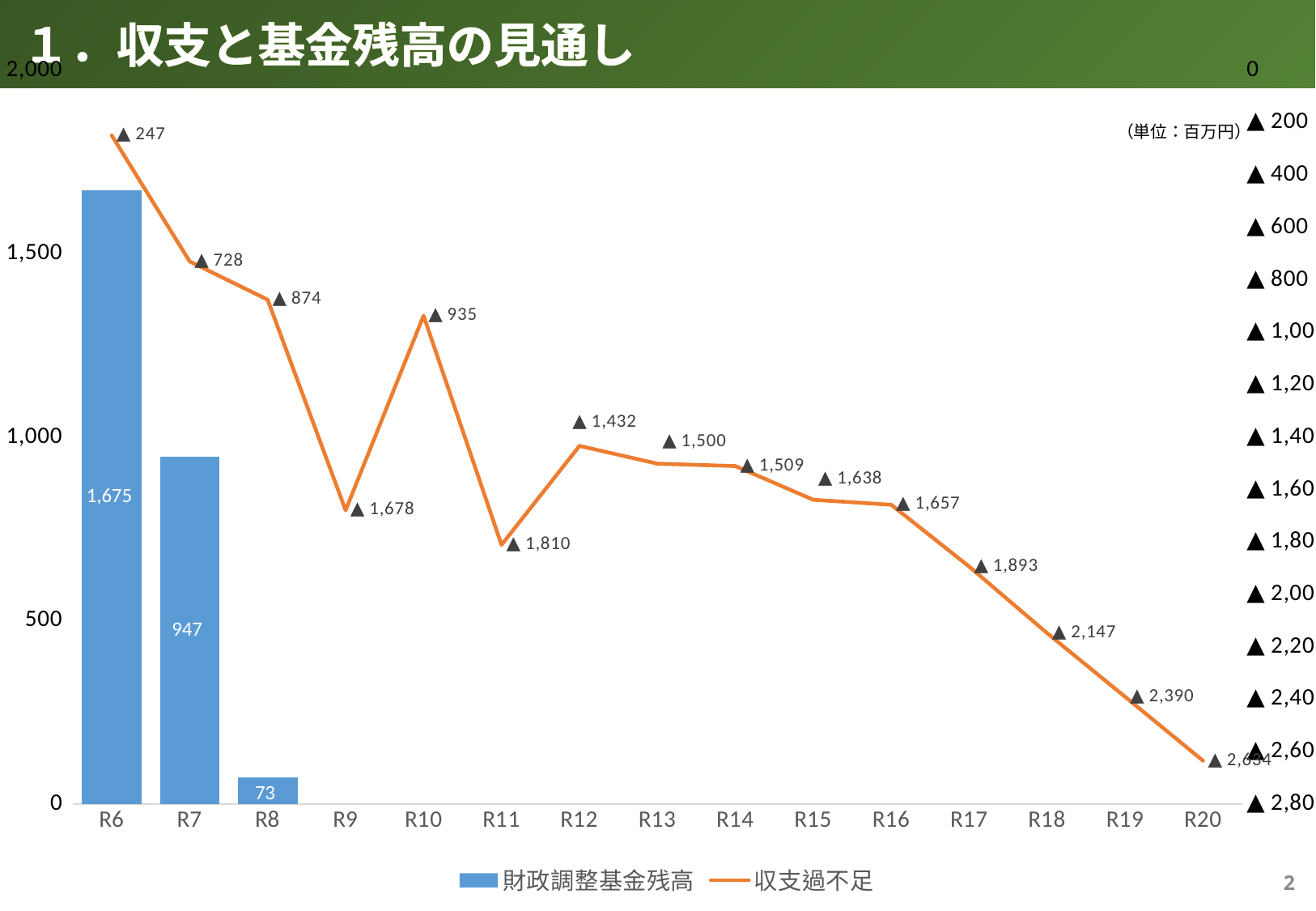
How many series does the legend list? 2 What is the difference between the 財政調整基金残高 values for R6 and R7? 728 How many years are shown on the x axis? 15 What is the 収支過不足 value labelled for R19? ▲ 2,390 Which is larger, the 財政調整基金残高 bar for R7 or for R8? R7 What is the 収支過不足 value labelled for R11? ▲ 1,810 What is the value of 財政調整基金残高 for R6? 1,675 Which year has the highest 財政調整基金残高 bar? R6 What is the value of 財政調整基金残高 for R8? 73 What unit is stated for the chart values? 百万円 What is the 収支過不足 value labelled for R6? ▲ 247 What is the value of 財政調整基金残高 for R7? 947